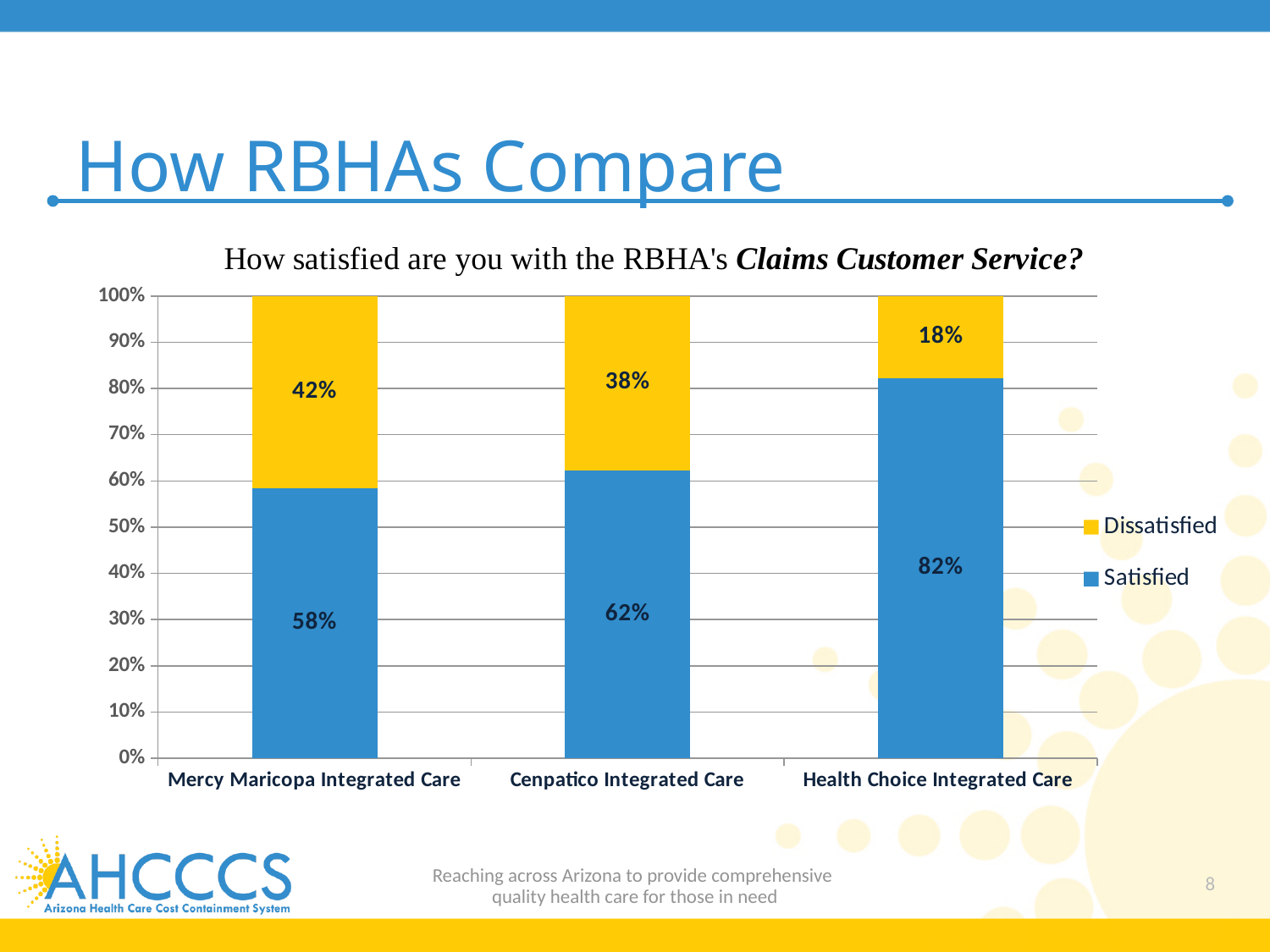
Which is larger, the Satisfied value for Cenpatico Integrated Care or the Satisfied value for Mercy Maricopa Integrated Care? Cenpatico Integrated Care Which RBHA has the highest Satisfied value? Health Choice Integrated Care What is the total of the stacked bar for Cenpatico Integrated Care? 100% Which colour represents the Dissatisfied series? Yellow What kind of chart is shown? Stacked bar chart How many RBHAs are shown on the x axis? 3 What is the Satisfied value for Health Choice Integrated Care? 82% How many series does the legend list? 2 What is the Satisfied value for Mercy Maricopa Integrated Care? 58% What is the Dissatisfied value for Cenpatico Integrated Care? 38% What is the difference between the Satisfied values for Health Choice Integrated Care and Mercy Maricopa Integrated Care? 24% Which RBHA has the lowest Dissatisfied value? Health Choice Integrated Care